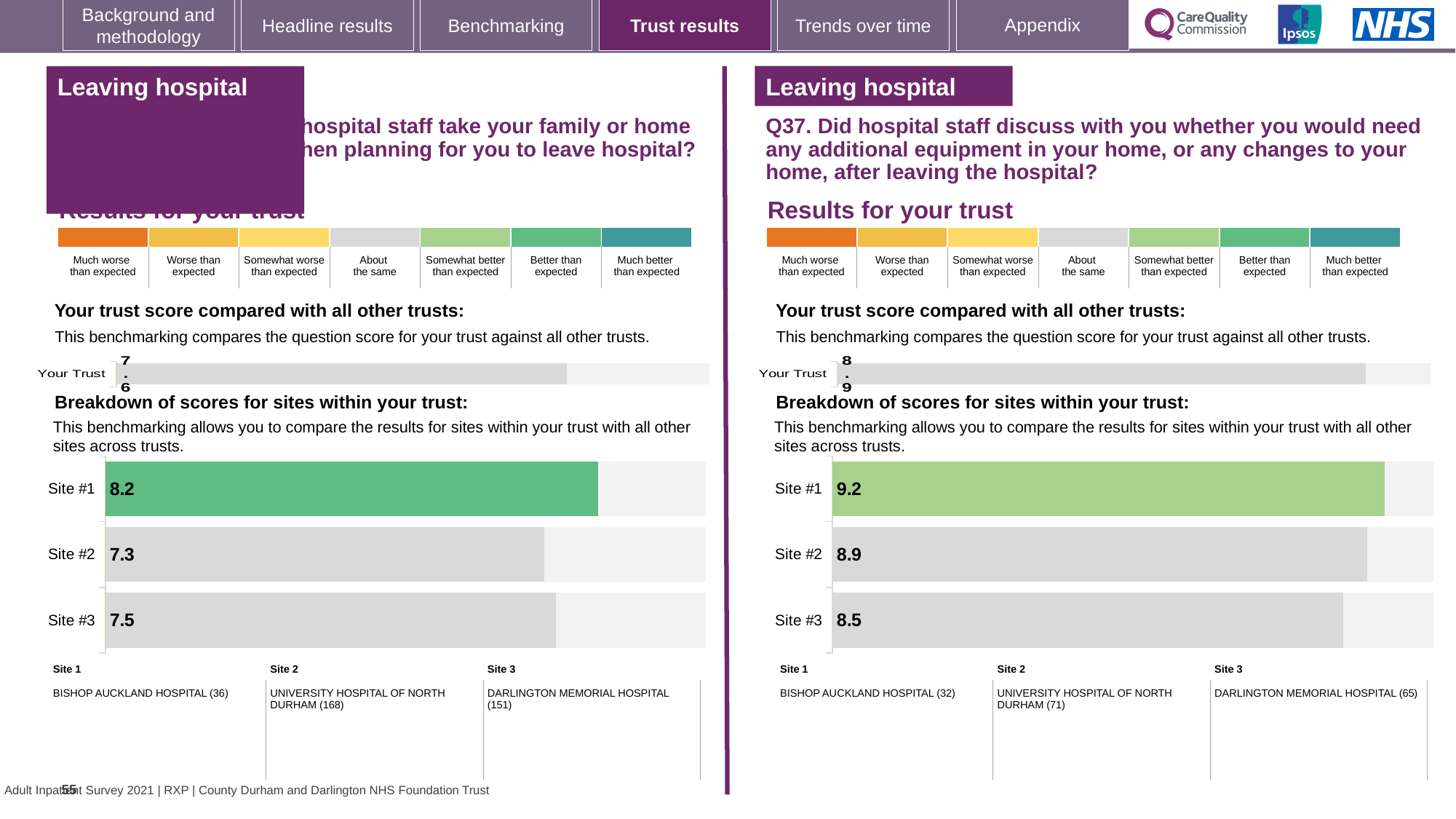
On the left-hand site breakdown chart, what is the score for Site #2? 7.3 On the right-hand site breakdown chart (Q37), what is the difference between the scores for Site #1 and Site #3? 0.7 What type of chart is used for the breakdown of scores for sites within your trust? Bar chart How many sites are shown on the left-hand site breakdown chart? 3 On the right-hand 'Your trust score compared with all other trusts' chart (Q37), what is the score for Your Trust? 8.9 On the left-hand site breakdown chart, what is the difference between the scores for Site #1 and Site #2? 0.9 On the right-hand site breakdown chart (Q37), which has the larger score, Site #2 or Site #3? Site #2 On the left-hand site breakdown chart, what is the score for Site #1? 8.2 On the right-hand site breakdown chart (Q37), what is the score for Site #3? 8.5 On the left-hand site breakdown chart, which site's bar is coloured green rather than grey? Site #1 On the right-hand site breakdown chart (Q37), which site has the highest score? Site #1 On the left-hand site breakdown chart, which site has the lowest score? Site #2